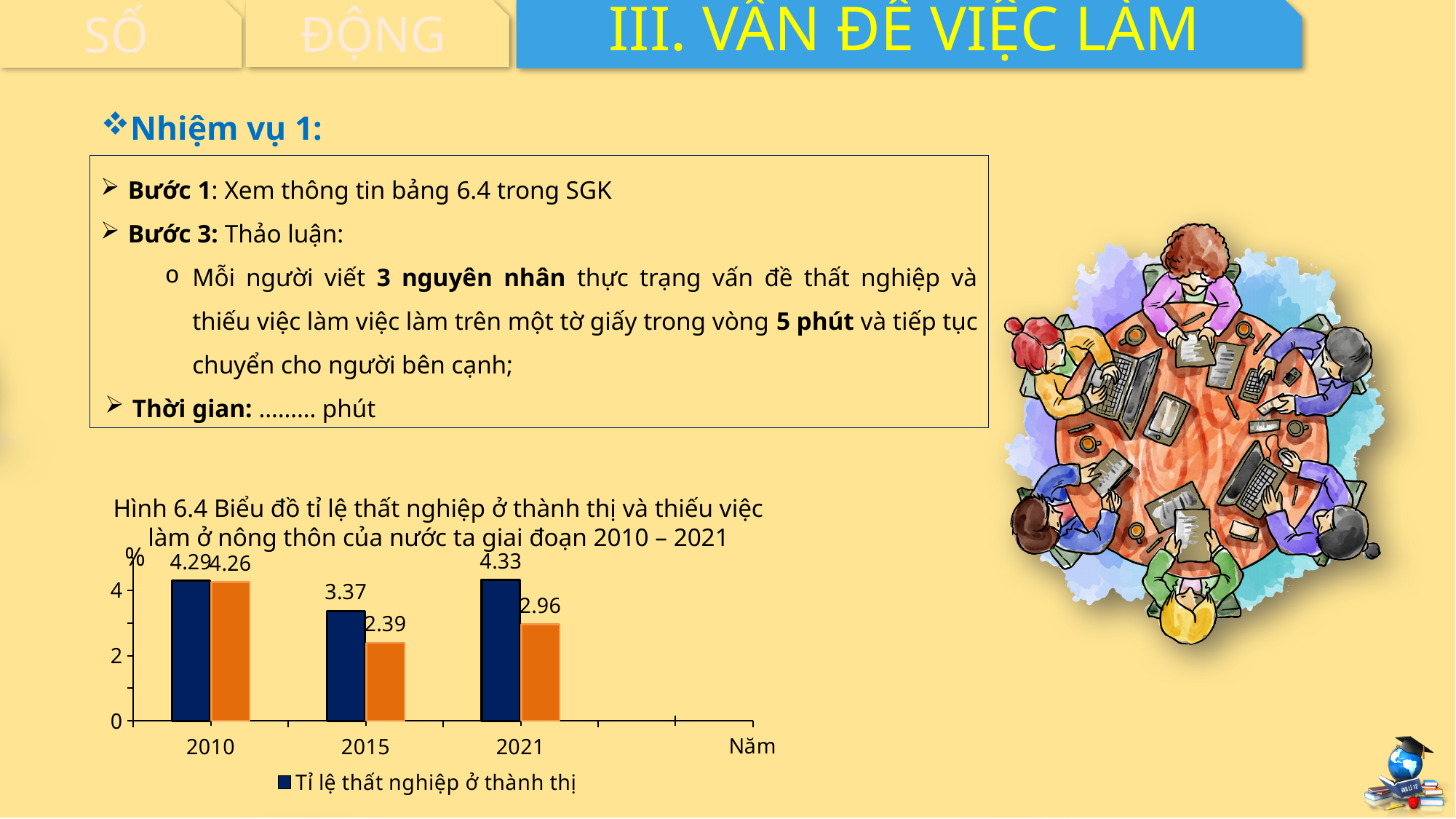
In which year is the urban unemployment rate (dark blue bar) the highest? 2021 What is the difference between the dark blue bar and the orange bar in 2015? 0.98 What value does the orange bar show for 2010? 4.26 In which year is the orange bar the lowest? 2015 What value does the orange bar show for 2015? 2.39 What is the difference between the dark blue bar and the orange bar in 2021? 1.37 In 2021, which is larger: the dark blue bar or the orange bar? The dark blue bar (4.33) What is the urban unemployment rate (Tỉ lệ thất nghiệp ở thành thị) shown for 2010? 4.29 What type of chart is shown on the slide? Bar chart Does the urban unemployment rate (dark blue bar) rise or fall from 2010 to 2015? Fall What is the value of the dark blue bar (Tỉ lệ thất nghiệp ở thành thị) for 2021? 4.33 How many years are shown on the x axis of the chart? 3